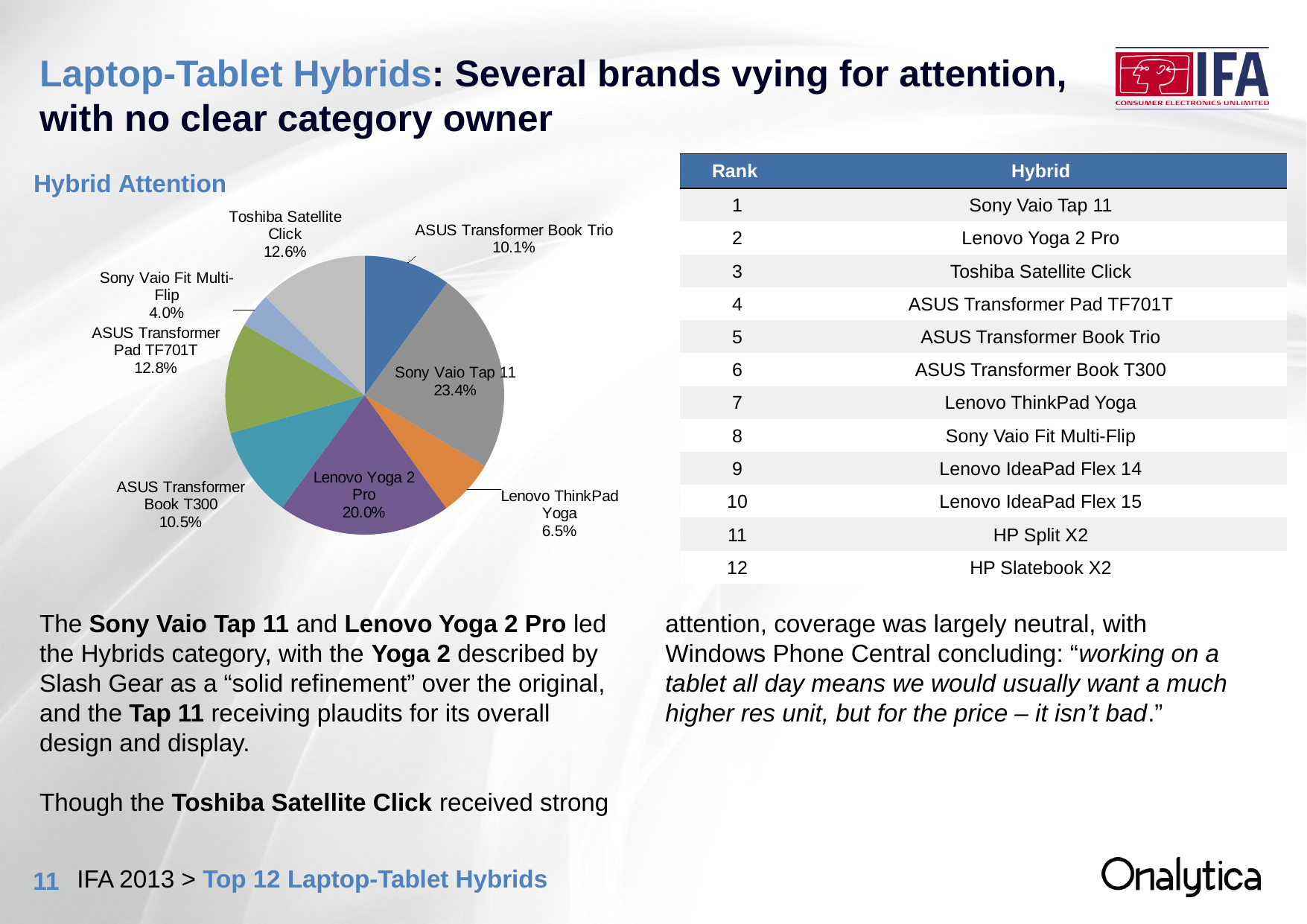
In the Hybrid Attention pie chart, which has the larger share: ASUS Transformer Pad TF701T or ASUS Transformer Book T300? ASUS Transformer Pad TF701T What share of the Hybrid Attention pie does Lenovo ThinkPad Yoga have? 6.5% What share of the Hybrid Attention pie does Sony Vaio Tap 11 have? 23.4% What share of the Hybrid Attention pie does Toshiba Satellite Click have? 12.6% In the Hybrid Attention pie chart, what is the difference between the shares of ASUS Transformer Book T300 and ASUS Transformer Book Trio? 0.4% Which hybrid has the largest slice in the Hybrid Attention pie chart? Sony Vaio Tap 11 Which hybrid has the smallest slice in the Hybrid Attention pie chart? Sony Vaio Fit Multi-Flip What kind of chart is the Hybrid Attention chart? pie chart What is the title of the pie chart on the slide? Hybrid Attention How many slices does the Hybrid Attention pie chart have? 8 What share of the Hybrid Attention pie does Lenovo Yoga 2 Pro have? 20.0% In the Hybrid Attention pie chart, what is the difference between the shares of Sony Vaio Tap 11 and Lenovo Yoga 2 Pro? 3.4%